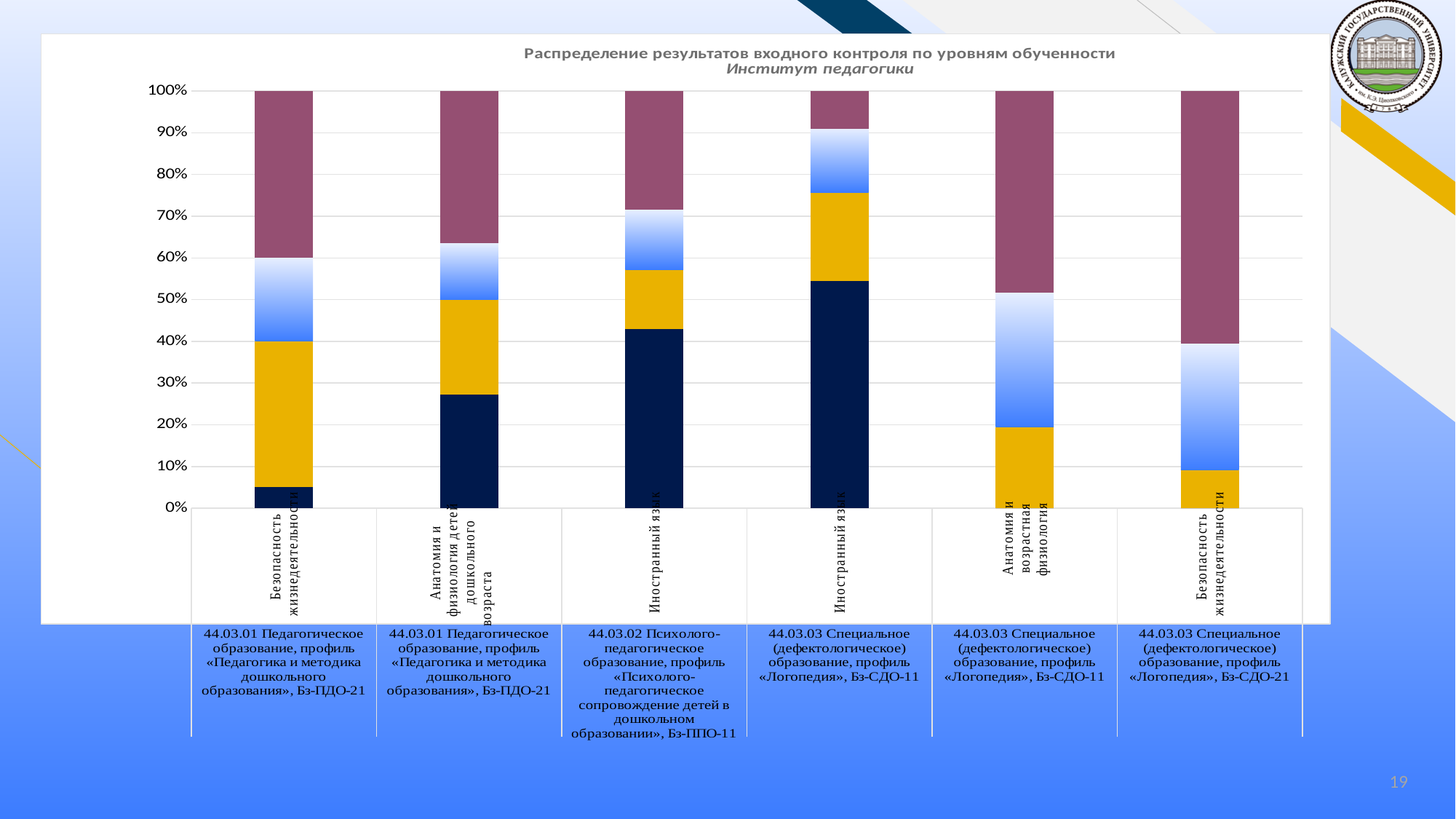
Which institute is named in the chart subtitle? Институт педагогики Which bar has the largest purple (top) segment? Безопасность жизнедеятельности, Бз-СДО-21 Is the top of the dark navy (bottom) segment for Безопасность жизнедеятельности, Бз-ПДО-21 greater or less than 10%? less How many bars (subject/program categories) are plotted in the chart? 6 Which bar has the largest dark navy (bottom) segment? Иностранный язык, Бз-СДО-11 Is the top of the dark navy (bottom) segment for Иностранный язык, Бз-СДО-11 greater or less than 50%? greater What is the main title of the chart? Распределение результатов входного контроля по уровням обученности What kind of chart is shown on the slide? Stacked bar chart Which bar has the smallest purple (top) segment? Иностранный язык, Бз-СДО-11 Is the top of the yellow segment for Иностранный язык, Бз-ППО-11 greater or less than 50%? greater Is the dark navy segment larger for Иностранный язык, Бз-ППО-11 or for Анатомия и физиология детей дошкольного возраста, Бз-ПДО-21? Иностранный язык, Бз-ППО-11